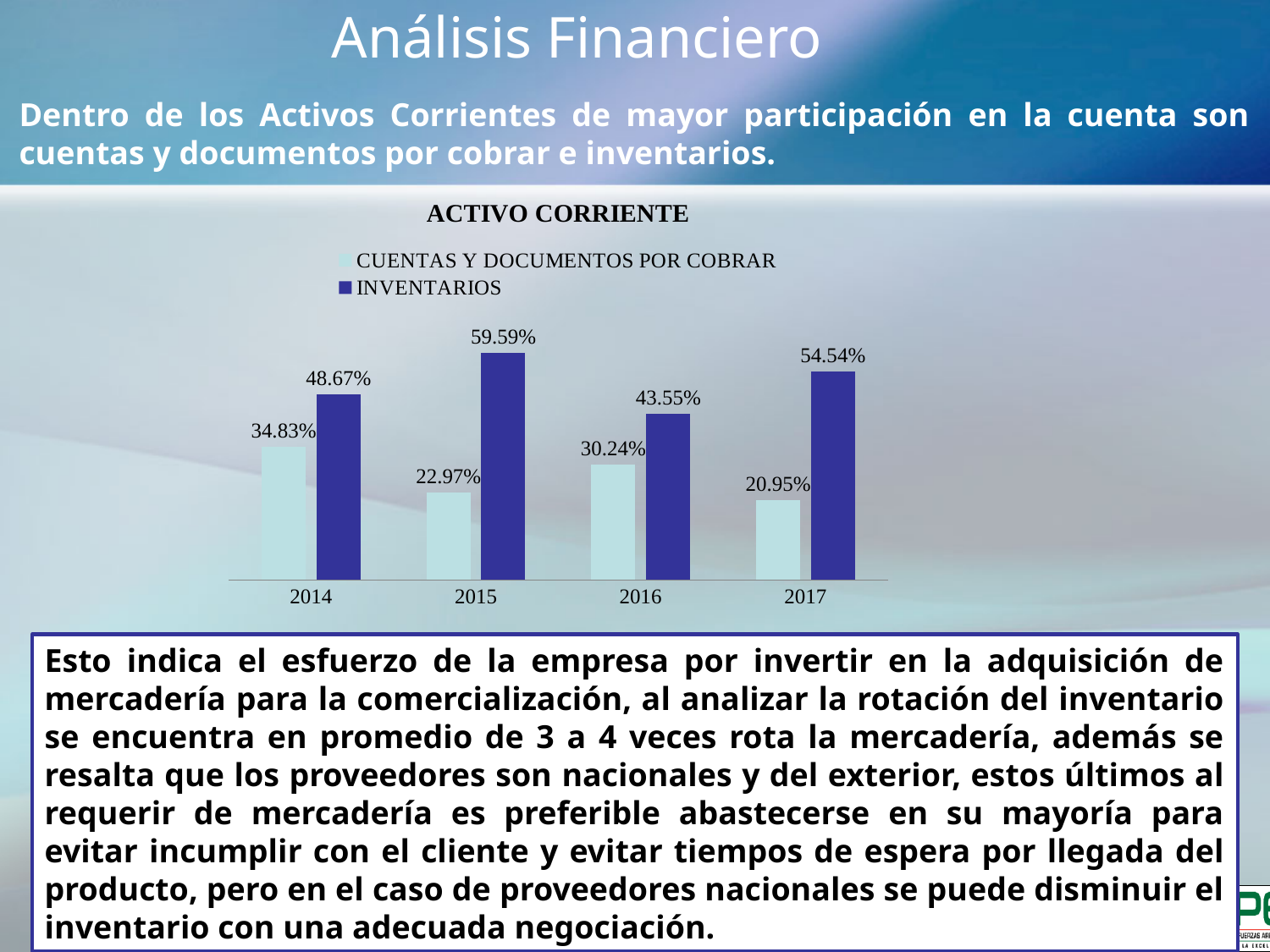
What is the value for INVENTARIOS in 2016? 43.55% What is the value for INVENTARIOS in 2015? 59.59% How many series does the legend list? 2 How many years are shown on the x axis? 4 In which year is the CUENTAS Y DOCUMENTOS POR COBRAR value lowest? 2017 Which is larger in 2016: INVENTARIOS or CUENTAS Y DOCUMENTOS POR COBRAR? INVENTARIOS What is the value for CUENTAS Y DOCUMENTOS POR COBRAR in 2014? 34.83% In which year is the INVENTARIOS value highest? 2015 What is the difference between INVENTARIOS and CUENTAS Y DOCUMENTOS POR COBRAR in 2015? 36.62% What is the difference between INVENTARIOS and CUENTAS Y DOCUMENTOS POR COBRAR in 2014? 13.84% What type of chart is shown? Bar chart What is the value for CUENTAS Y DOCUMENTOS POR COBRAR in 2017? 20.95%